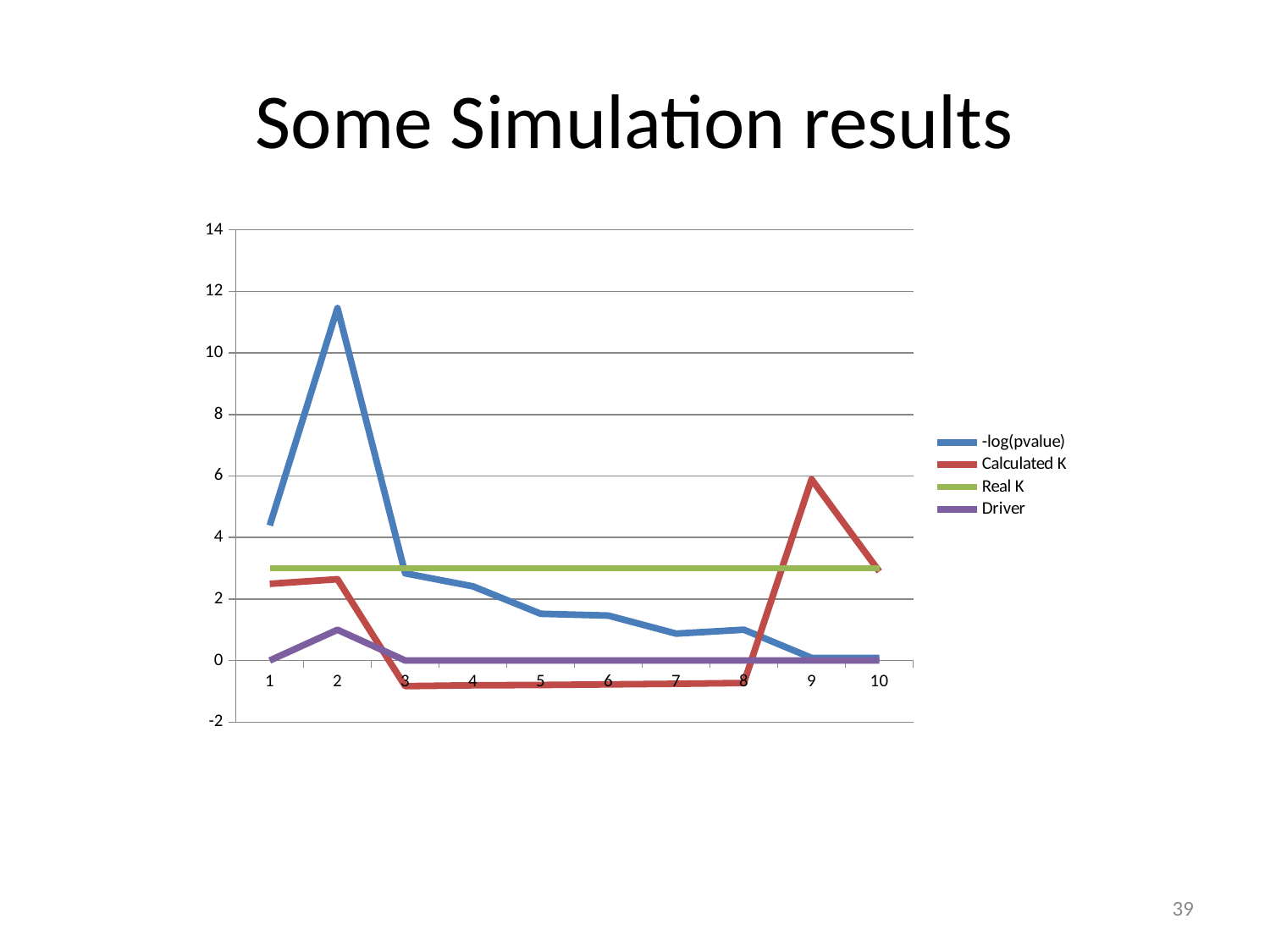
At x = 2, which series has the larger value, -log(pvalue) or Calculated K? -log(pvalue) Is the value of Real K greater or less than 2? greater At which x value does the Calculated K series reach its highest point? 9 How many series does the legend list? 4 What is the title of the slide containing the chart? Some Simulation results How many points are there along the x axis? 10 Is the value of -log(pvalue) at x = 2 greater or less than 10? greater What kind of chart is shown on the slide? line chart At which x value does the -log(pvalue) series reach its highest point? 2 At x = 9, which series has the larger value, Calculated K or -log(pvalue)? Calculated K Is the value of Calculated K at x = 9 greater or less than 4? greater Does the -log(pvalue) series rise or fall from x = 2 to x = 9? fall